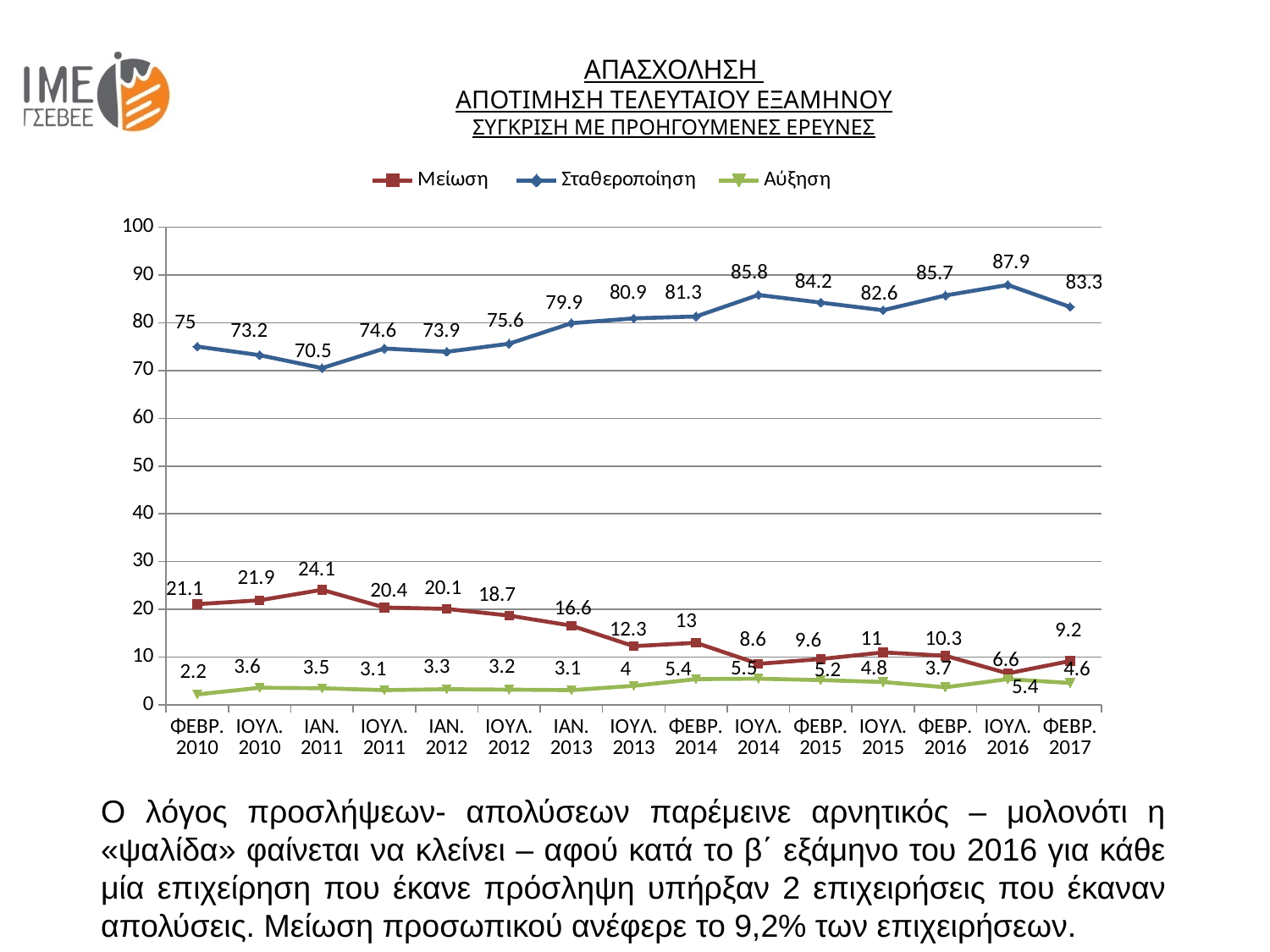
How many time periods are shown on the x axis? 15 What is the difference between the Σταθεροποίηση values for ΙΟΥΛ. 2016 and ΦΕΒΡ. 2017? 4.6 What is the value of Αύξηση for ΦΕΒΡ. 2010? 2.2 Which is larger, the Μείωση value for ΙΟΥΛ. 2014 or for ΦΕΒΡ. 2015? ΦΕΒΡ. 2015 How many series does the legend list? 3 Is the Σταθεροποίηση value for ΙΟΥΛ. 2014 greater or less than 80? greater In which period does Μείωση reach its highest value? ΙΑΝ. 2011 In which period does Σταθεροποίηση reach its lowest value? ΙΑΝ. 2011 Does the Μείωση series generally rise or fall from ΦΕΒΡ. 2010 to ΦΕΒΡ. 2017? fall What is the value of Σταθεροποίηση for ΙΟΥΛ. 2016? 87.9 What is the value of Μείωση for ΦΕΒΡ. 2017? 9.2 What kind of chart is shown on the slide? line chart